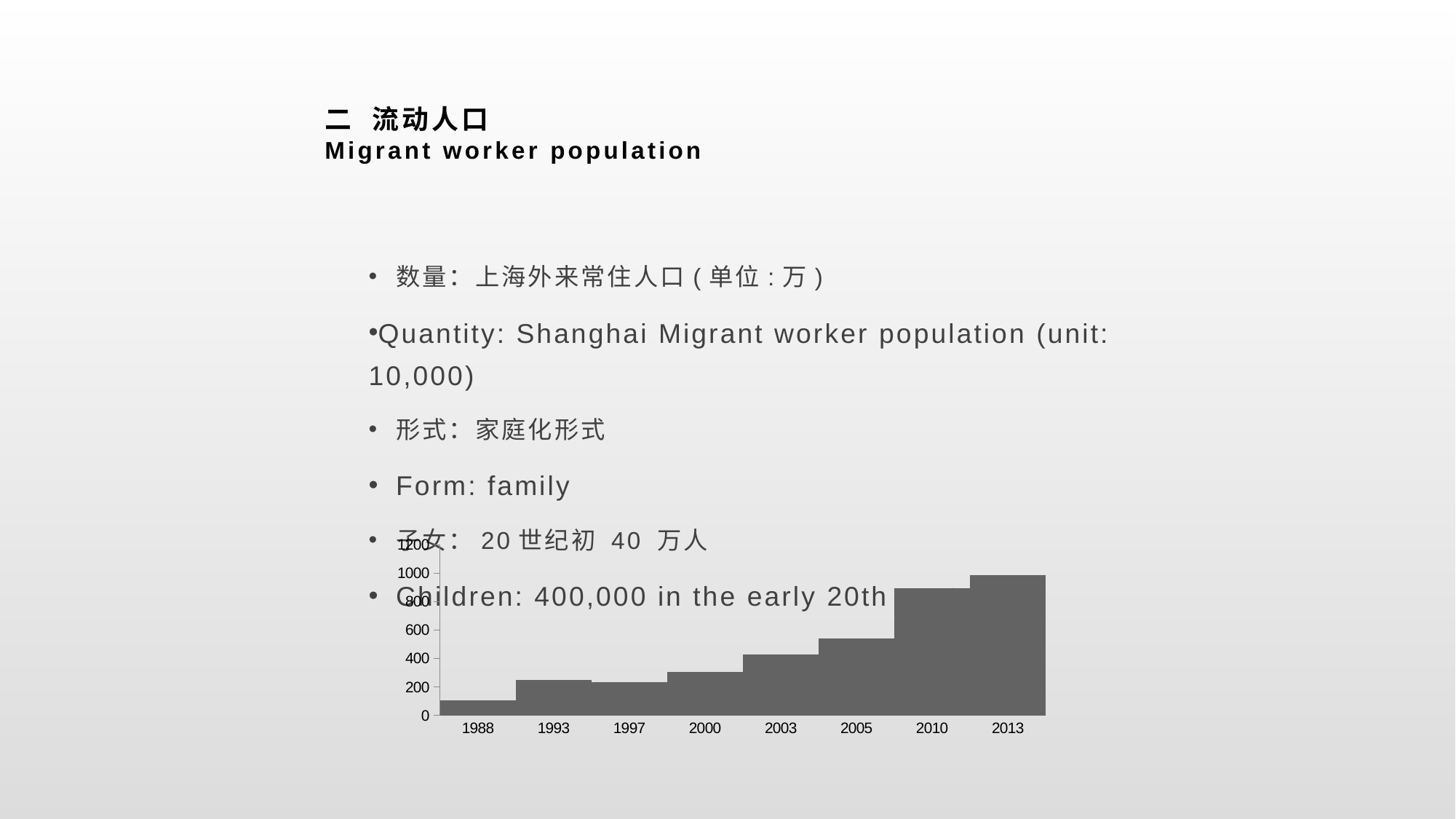
How many years are shown on the x axis of the chart? 8 Which year has the lowest bar in the chart? 1988 Is the value for 2003 greater or less than 600? less What is the highest tick value shown on the y axis of the chart? 1200 Is the value for 2013 greater or less than 800? greater Is the value for 2010 greater or less than 1000? less Which year has the highest bar in the chart? 2013 What kind of chart is shown on the slide? bar chart Which is larger, the value for 2005 or the value for 2000? 2005 Do the values generally rise or fall from 1988 to 2013? rise